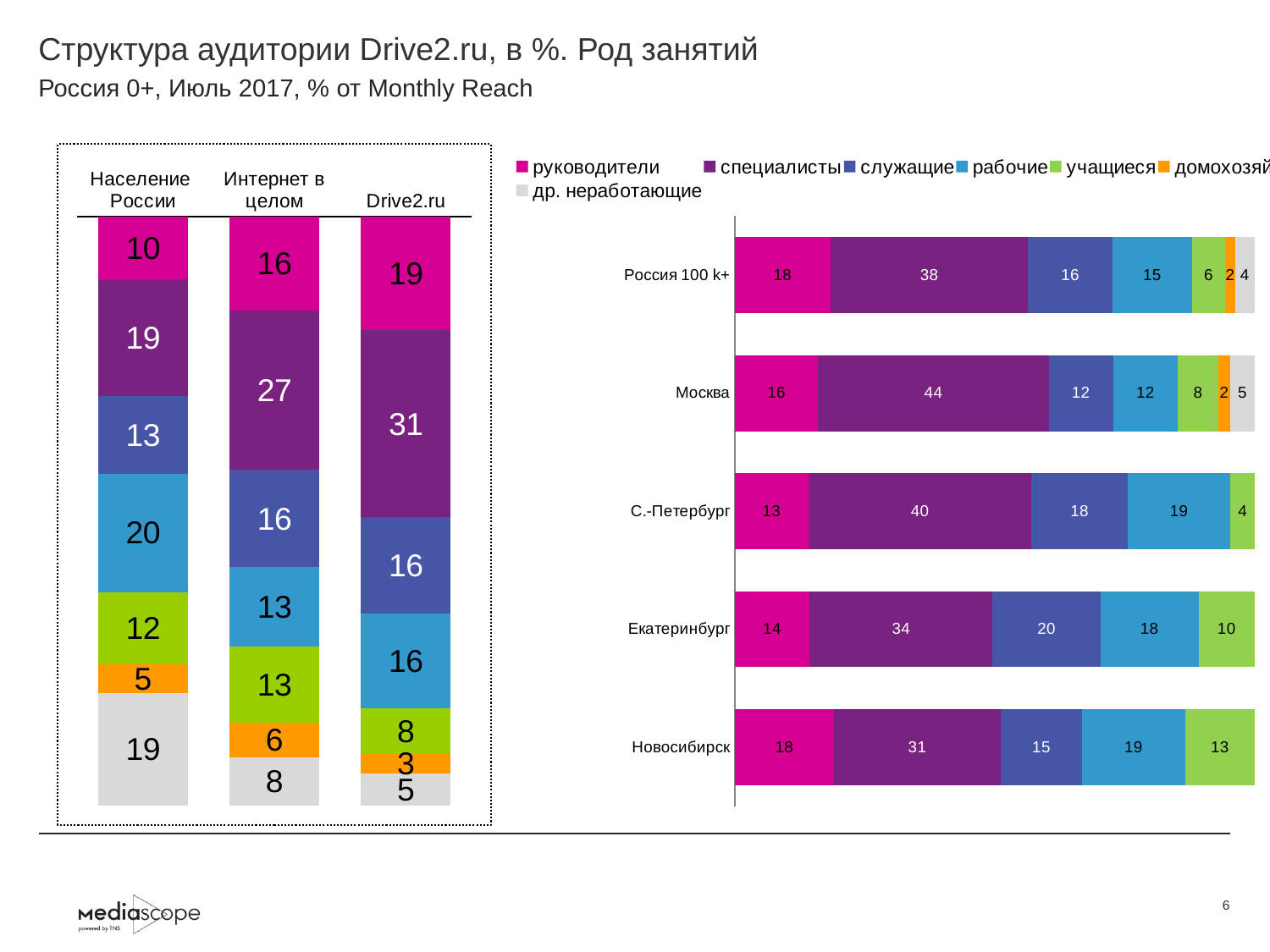
In the left chart, what is the value of the руководители segment for Население России? 10 In the left chart, what is the value of the рабочие segment for Интернет в целом? 13 In the right chart, which is larger: the руководители value for Новосибирск or for С.-Петербург? Новосибирск In the right chart, which city has the highest специалисты value? Москва In the left chart, how many bars (audience groups) are shown? 3 In the left chart, what is the value of the специалисты segment for Drive2.ru? 31 In the left chart, what is the difference between the специалисты values for Drive2.ru and Население России? 12 How many series does the legend of the right chart list? 7 In the right chart, what is the value of the служащие segment for Екатеринбург? 20 What type of chart is the right chart? Stacked bar chart In the left chart, which of the three bars has the largest специалисты segment? Drive2.ru In the right chart, what is the value of the специалисты segment for Москва? 44